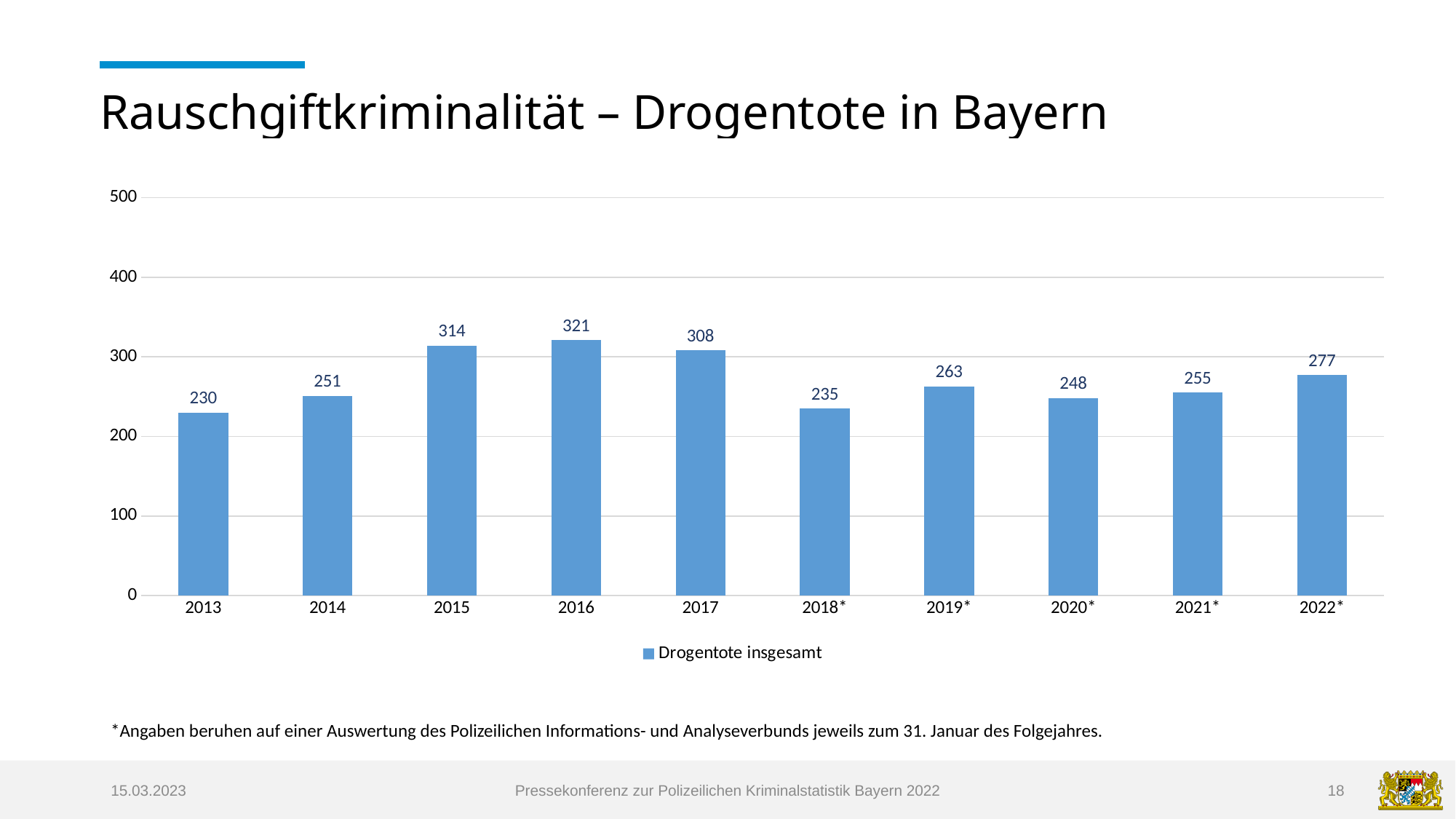
What is the difference between the values for 2016 and 2013? 91 Which is larger, the value for 2015 or the value for 2017? 2015 Which year has the highest value? 2016 What is the value for 2016? 321 How many years are shown on the x axis? 10 What is the difference between the values for 2022* and 2021*? 22 What is the value for 2018*? 235 Which year has the lowest value? 2013 What is the value for 2022*? 277 What is the legend entry for the series shown? Drogentote insgesamt Is the value for 2019* greater or less than 300? less What kind of chart is shown on the slide? bar chart